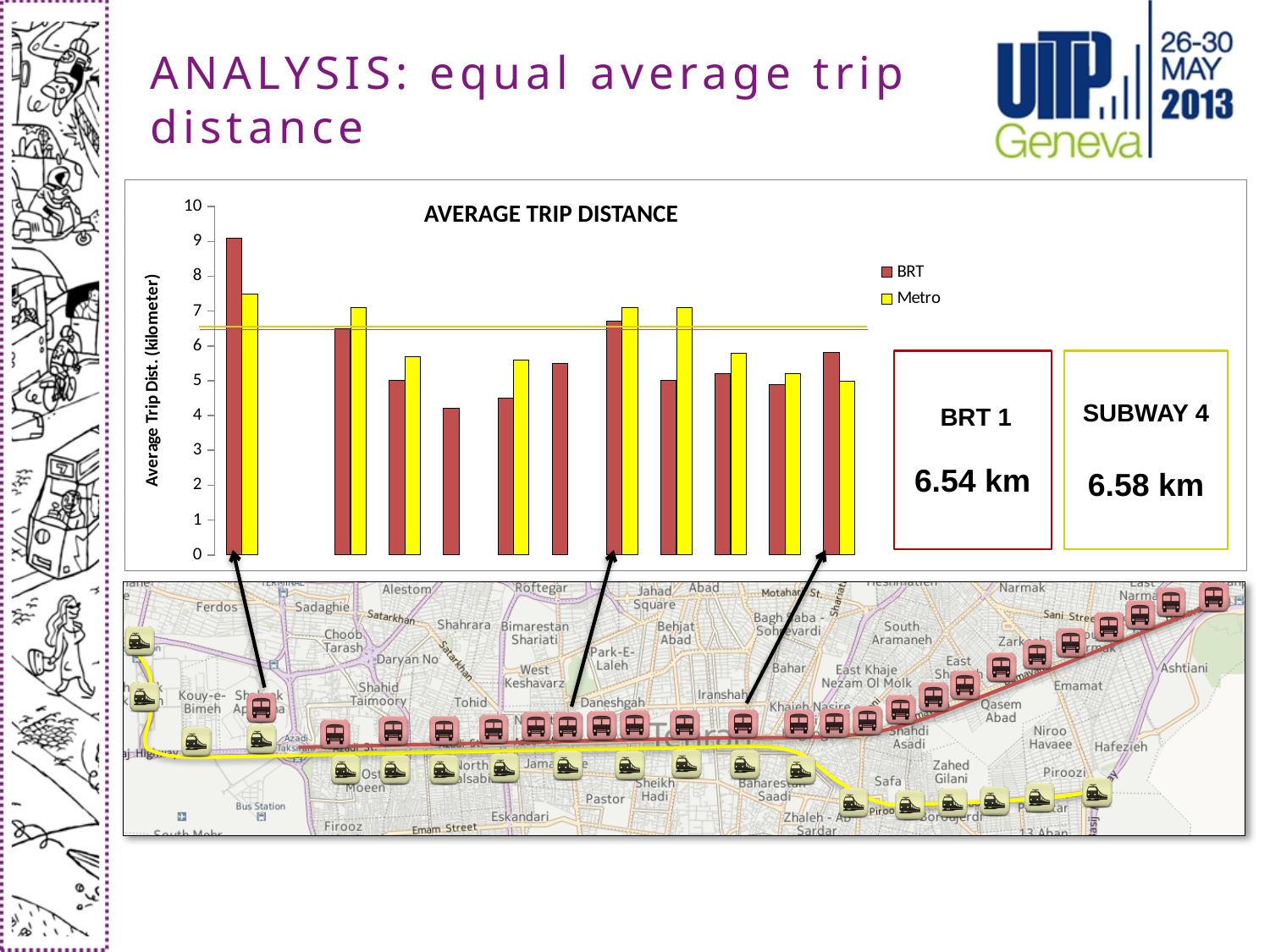
What are the two series named in the legend of the AVERAGE TRIP DISTANCE chart? BRT and Metro What kind of chart is the AVERAGE TRIP DISTANCE chart? bar chart In the leftmost group of the AVERAGE TRIP DISTANCE chart, which bar is taller, BRT or Metro? BRT In the AVERAGE TRIP DISTANCE chart, is the leftmost Metro bar greater or less than 7? greater What is the label of the vertical axis of the AVERAGE TRIP DISTANCE chart? Average Trip Dist. (kilometer) In the AVERAGE TRIP DISTANCE chart, is the leftmost BRT bar greater or less than 8? greater In the AVERAGE TRIP DISTANCE chart, which series has the tallest bar overall? BRT Which has the larger average trip distance in the boxes, BRT 1 or SUBWAY 4? SUBWAY 4 What average trip distance is shown in the box for BRT 1? 6.54 km How many series does the legend of the AVERAGE TRIP DISTANCE chart list? 2 What is the difference between the SUBWAY 4 and BRT 1 average trip distances shown in the boxes? 0.04 km What average trip distance is shown in the box for SUBWAY 4? 6.58 km